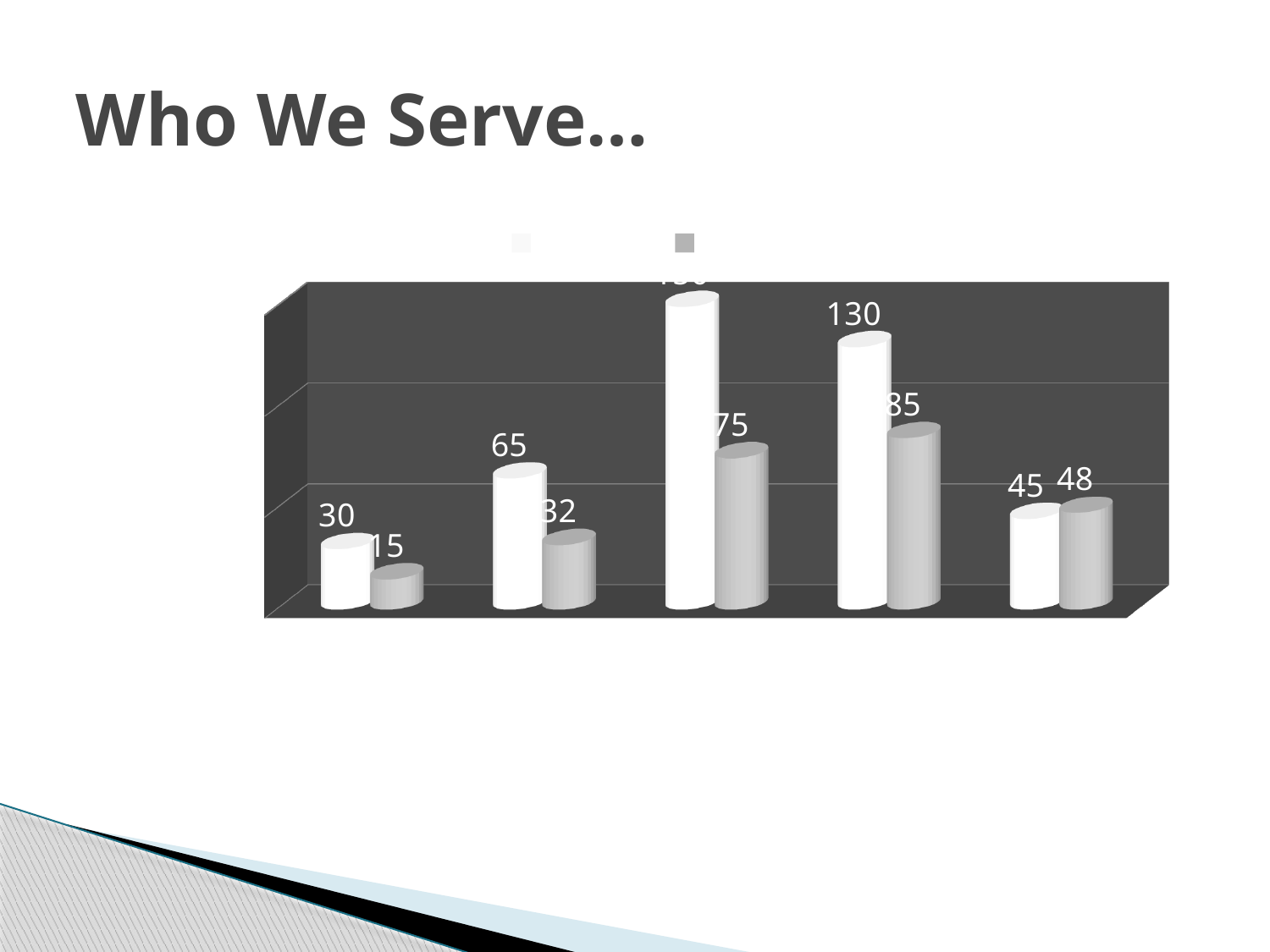
How many series does the chart plot (as shown by the two legend markers)? 2 What kind of chart is shown on the slide? bar chart In the fifth (rightmost) group, which bar is larger, the white bar or the gray bar? the gray bar (48) What is the value of the white bar in the second group from the left? 65 What is the value of the white bar in the first (leftmost) group? 30 What is the value of the white bar in the fourth group from the left? 130 How many category groups of bars does the chart contain? 5 Which group has the highest gray bar? the fourth group (85) What is the value of the gray bar in the first (leftmost) group? 15 What is the value of the gray bar in the third group from the left? 75 What is the difference between the white bar (130) and the gray bar (85) in the fourth group? 45 What is the value of the gray bar in the fifth (rightmost) group? 48